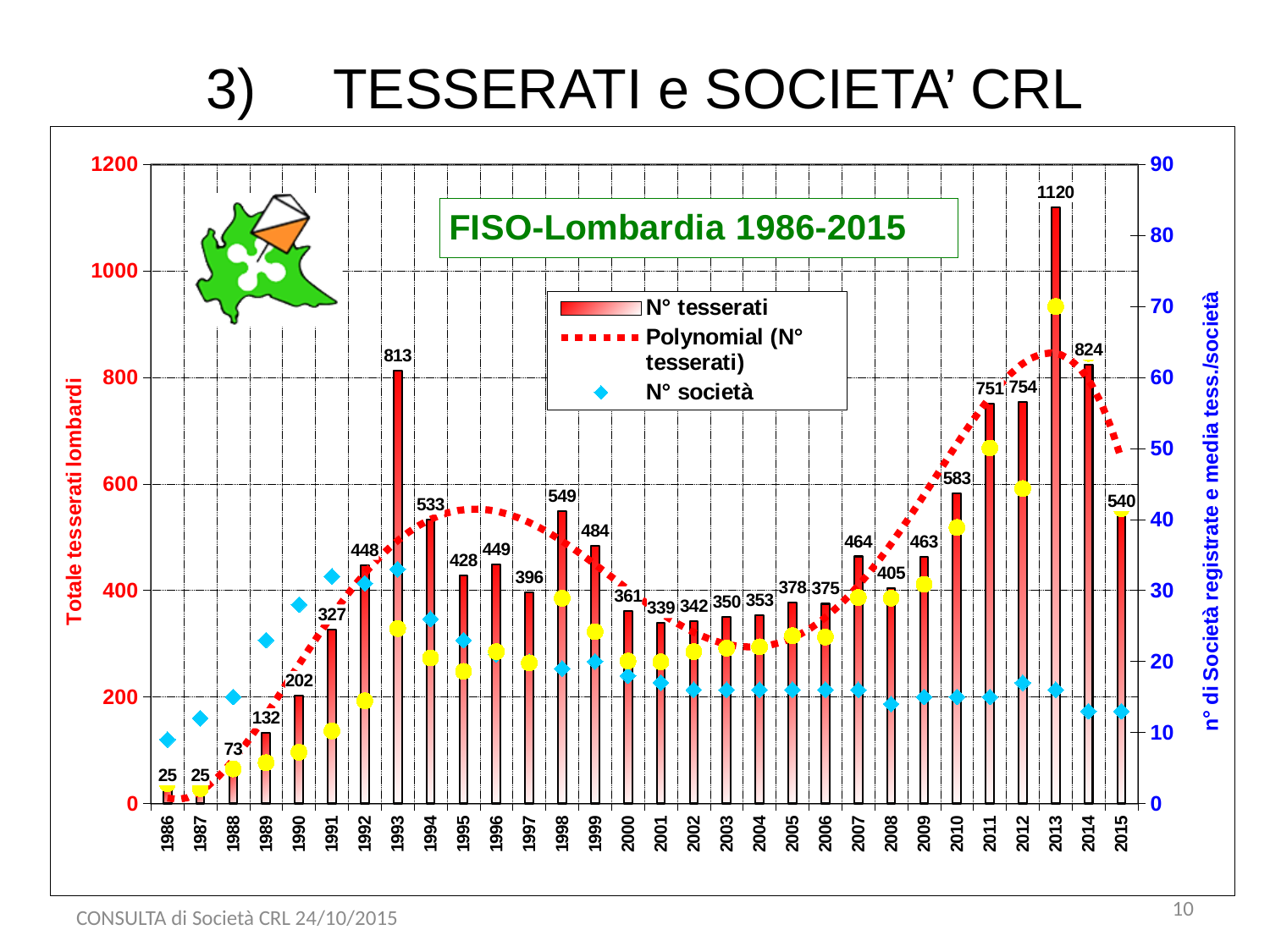
What is the difference in N° tesserati between 2013 and 2014? 296 Is the N° società value for 1993 greater or less than 30? greater How many years are shown on the x axis? 30 Is the N° società value for 2014 greater or less than 20? less How many entries does the legend list? 3 What is the value of N° tesserati for 2013? 1120 What is the value of N° tesserati for 1993? 813 Which year has the highest N° tesserati? 2013 Which year has the larger N° tesserati, 1994 or 1998? 1998 What is the value of N° tesserati for 2000? 361 What is the title shown inside the chart area? FISO-Lombardia 1986-2015 What is the difference in N° tesserati between 2011 and 2010? 168